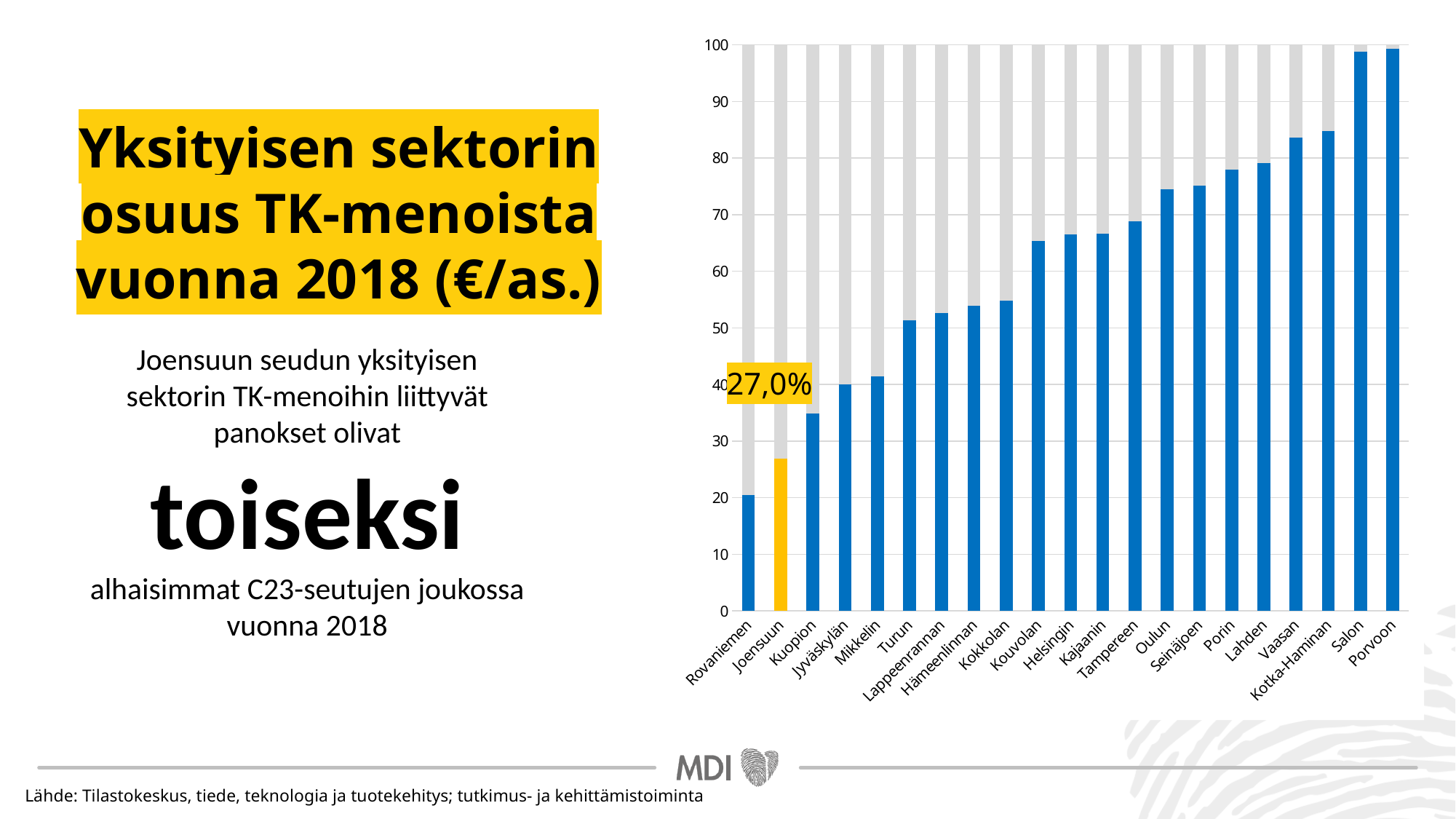
Is the value for Porin greater or less than 80? less What kind of chart is shown on the slide? bar chart Which category has the lowest bar? Rovaniemen How many categories are shown on the x axis? 21 What value is labelled on the bar for Joensuun? 27,0% Is the value for Rovaniemen greater or less than 30? less Which is larger, the value for Tampereen or the value for Kuopion? Tampereen Do the bar values rise or fall from left to right along the x axis? rise Is the value for Oulun greater or less than 70? greater Which category's bar is highlighted in yellow instead of blue? Joensuun